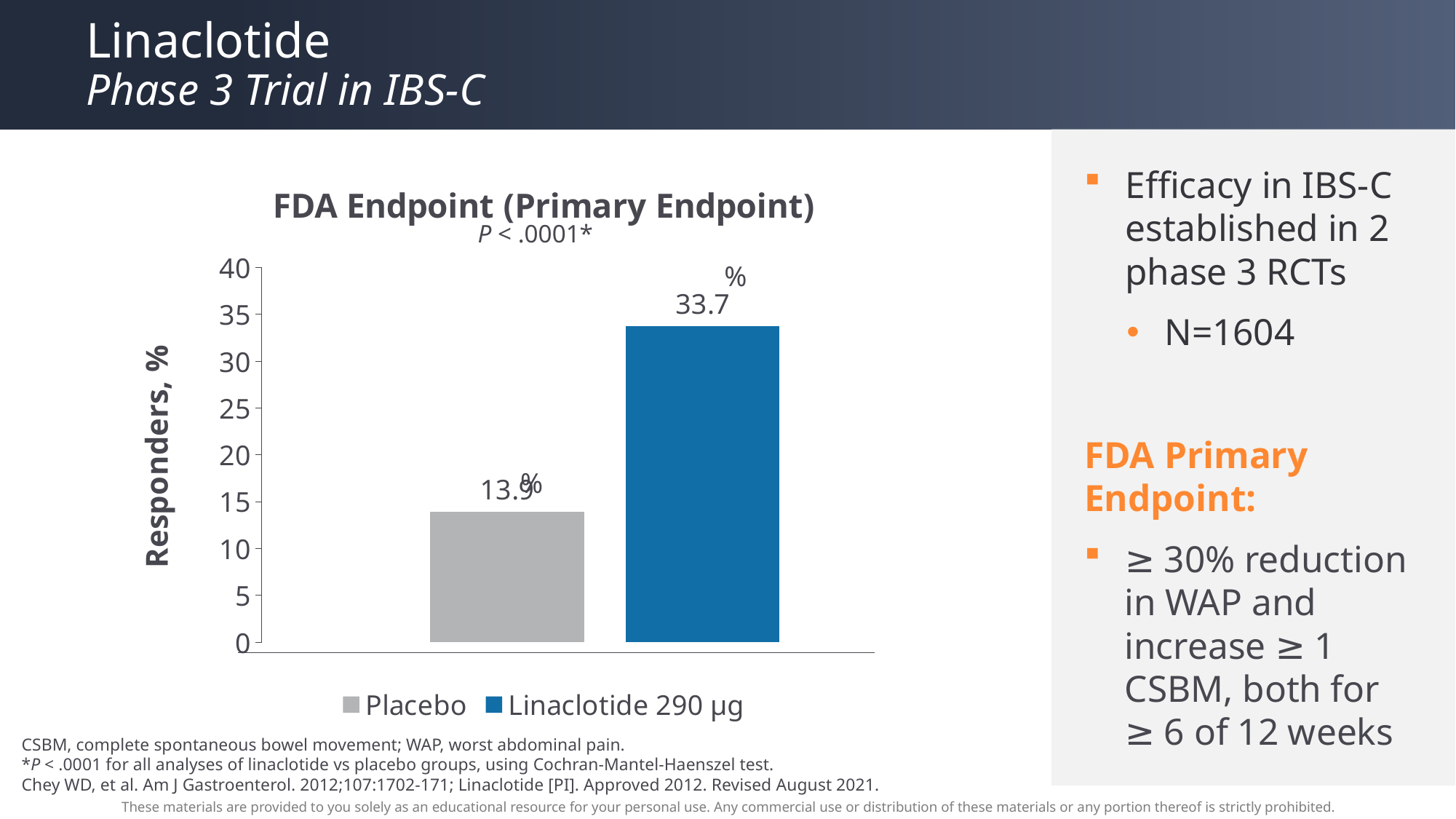
Is the responder rate for Placebo greater or less than 15? less What is the responder rate for Linaclotide 290 µg in the FDA Endpoint (Primary Endpoint) chart? 33.7% Which group has the lower responder rate in the chart? Placebo Is the responder rate for Linaclotide 290 µg greater or less than 30? greater What is the responder rate for Placebo in the FDA Endpoint (Primary Endpoint) chart? 13.9% What kind of chart is shown on the slide? Bar chart How many series does the legend list? 2 Which group has the higher responder rate in the chart? Linaclotide 290 µg What is the label on the y-axis of the chart? Responders, % What is the title of the chart? FDA Endpoint (Primary Endpoint) What is the difference in responder rate between Linaclotide 290 µg and Placebo? 19.8% How many bars are plotted in the chart? 2